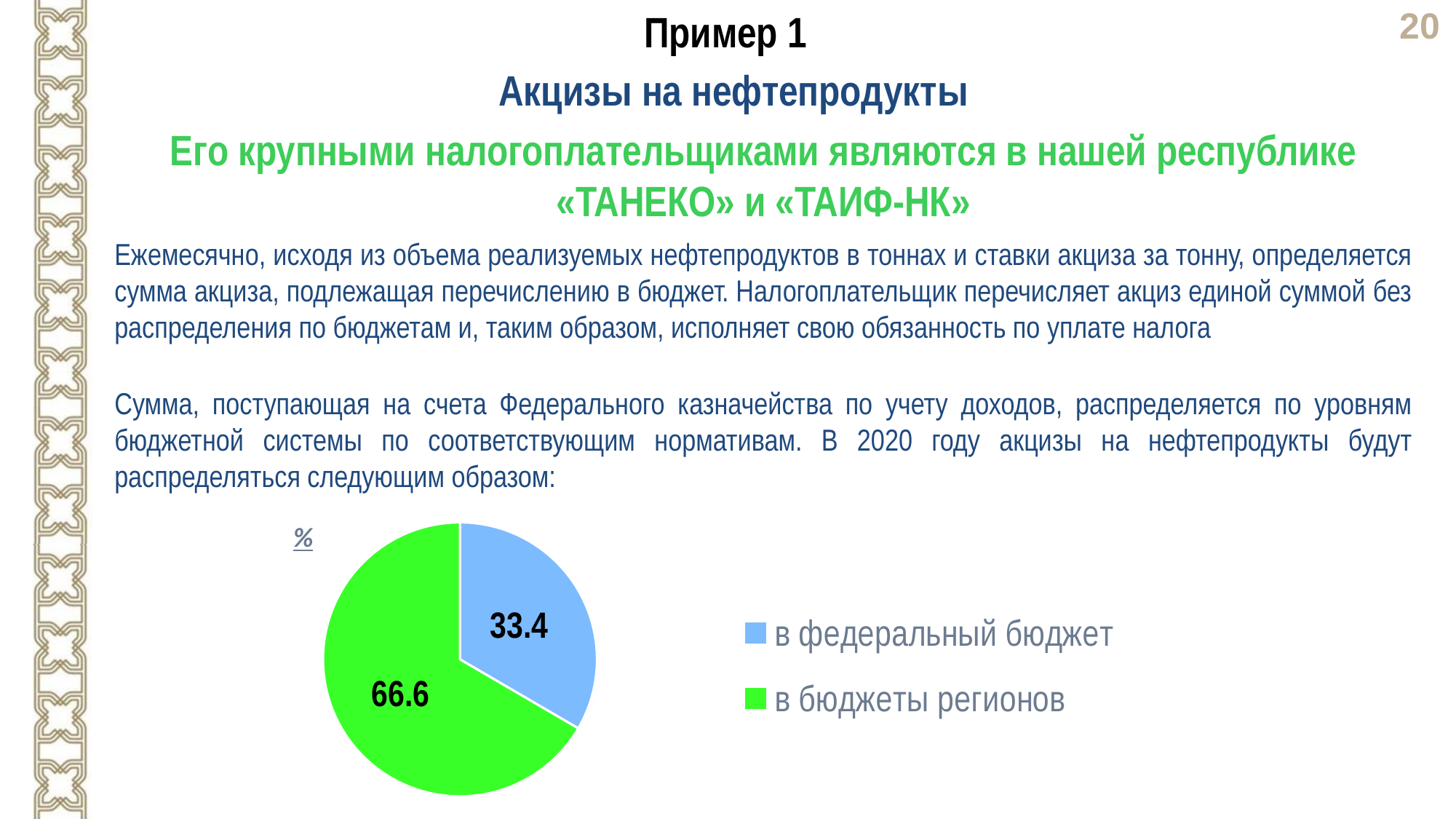
What unit label is shown next to the pie chart? % How many slices does the pie chart have? 2 What kind of chart is shown on the slide? pie chart What is the difference between the values for «в бюджеты регионов» and «в федеральный бюджет»? 33.2 Which slice of the pie is the largest? в бюджеты регионов What value is shown for «в бюджеты регионов»? 66.6 What value is shown for «в федеральный бюджет»? 33.4 How many entries does the legend list? 2 Which is larger: the value for «в федеральный бюджет» or for «в бюджеты регионов»? в бюджеты регионов What colour is the slice for «в федеральный бюджет»? blue Which slice of the pie is the smallest? в федеральный бюджет